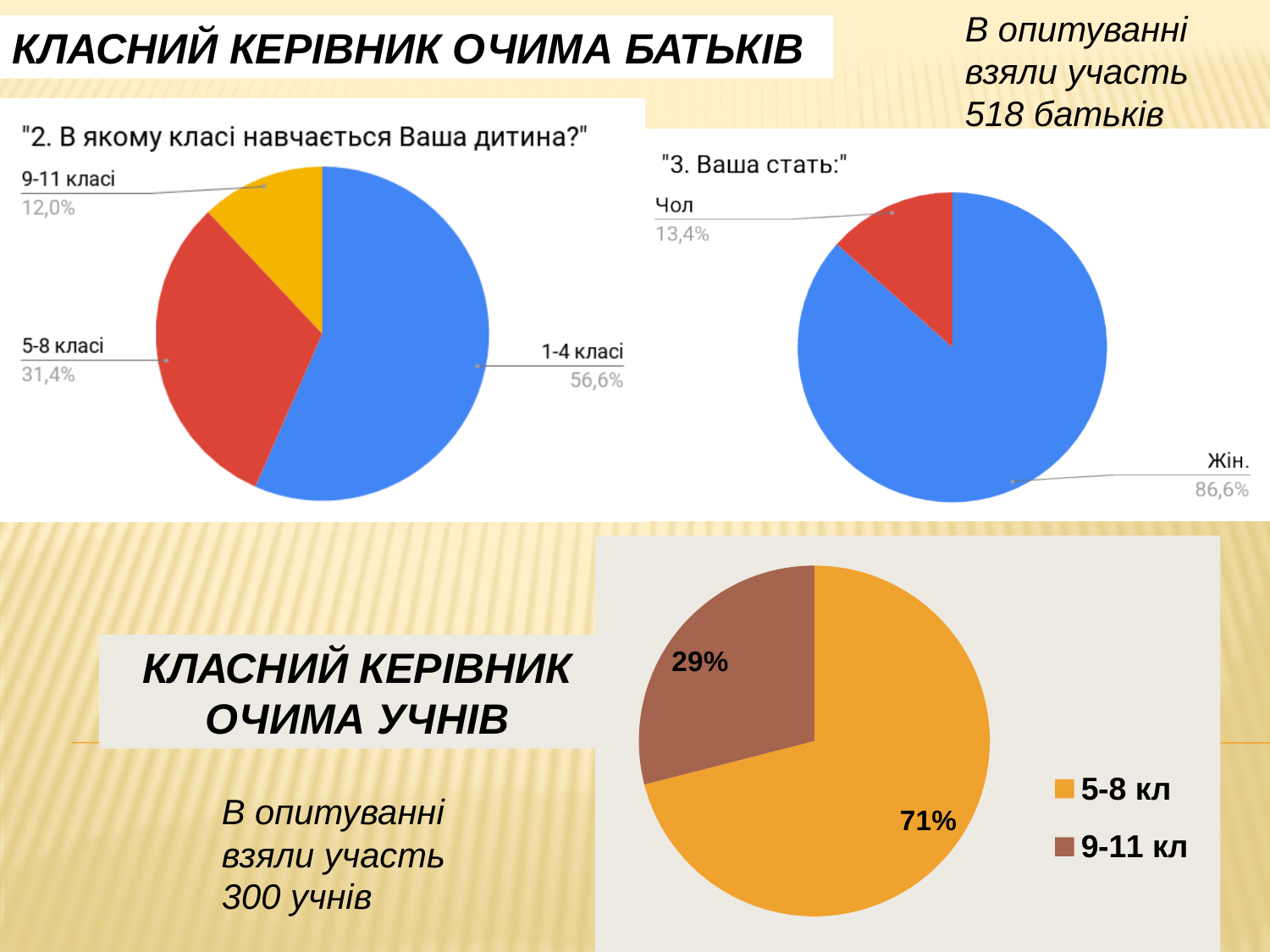
In the chart titled "2. В якому класі навчається Ваша дитина?", which category has the smallest slice? 9-11 класі In the pie chart at the bottom of the slide, what is the difference between the shares for 5-8 кл and 9-11 кл? 42% In the chart titled "2. В якому класі навчається Ваша дитина?", which category has the largest slice? 1-4 класі In the pie chart at the bottom of the slide, what share is shown for 5-8 кл? 71% In the chart titled "2. В якому класі навчається Ваша дитина?", what share is shown for 9-11 класі? 12,0% What type of chart is the chart at the bottom of the slide? Pie chart How many slices does the chart titled "2. В якому класі навчається Ваша дитина?" have? 3 In the chart titled "3. Ваша стать:", what share is shown for Жін.? 86,6% In the chart titled "2. В якому класі навчається Ваша дитина?", what share is shown for 1-4 класі? 56,6% In the chart titled "2. В якому класі навчається Ваша дитина?", what is the difference between the shares for 5-8 класі and 9-11 класі? 19,4% In the chart titled "3. Ваша стать:", what share is shown for Чол? 13,4% In the chart titled "3. Ваша стать:", which is larger, Чол or Жін.? Жін.